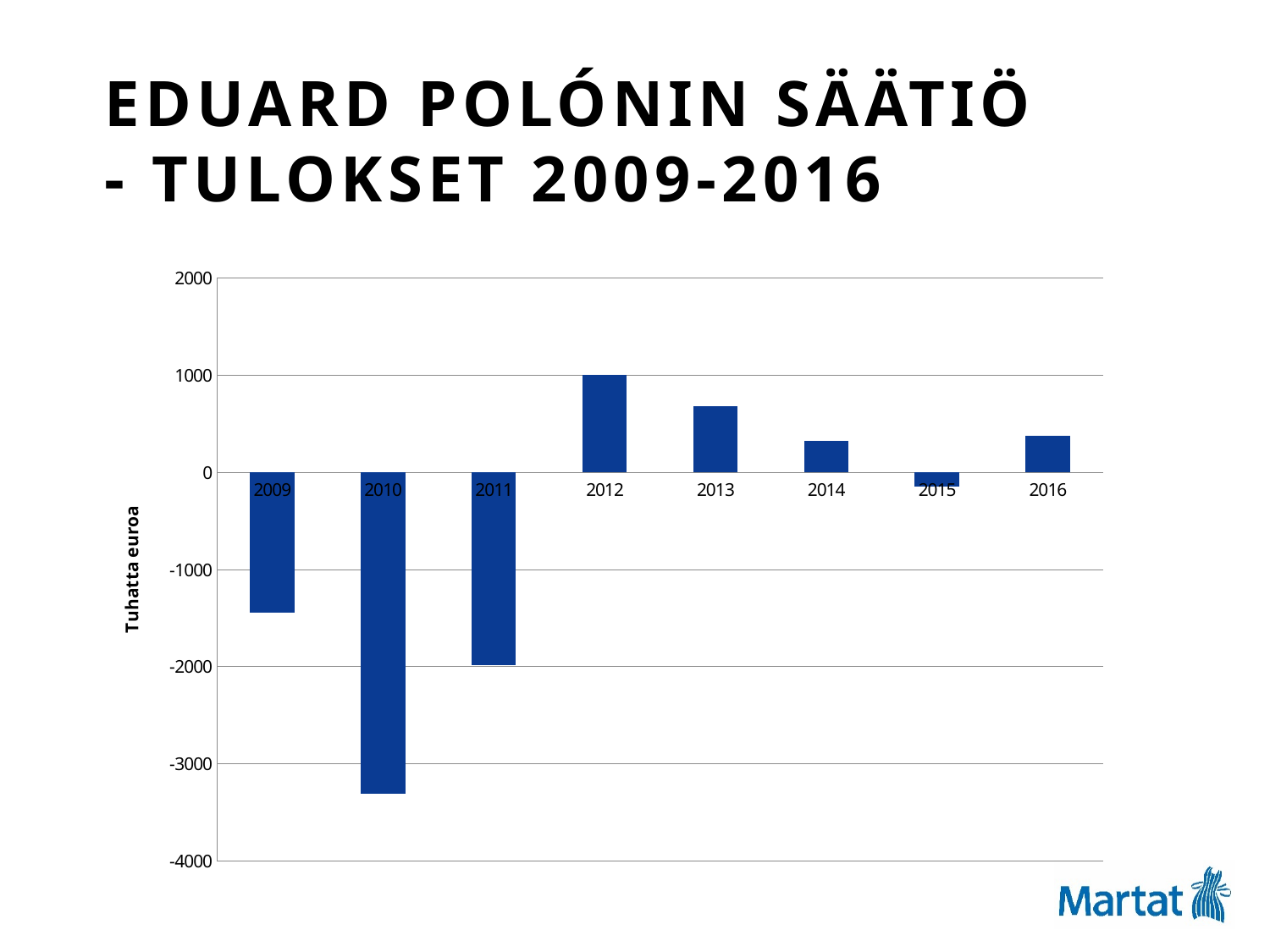
Which year has the larger value, 2013 or 2014? 2013 Which year has the highest value in the chart? 2012 How many years in the chart have a negative value? 4 Is the value for 2009 greater or less than -1000? less Which year has the larger value, 2009 or 2011? 2009 Is the value for 2010 greater or less than -3000? less What kind of chart is shown on the slide? bar chart Which year has the lowest value in the chart? 2010 What is the label on the vertical axis of the chart? Tuhatta euroa How many years are plotted on the x axis of the chart? 8 Is the value for 2014 greater or less than 500? less